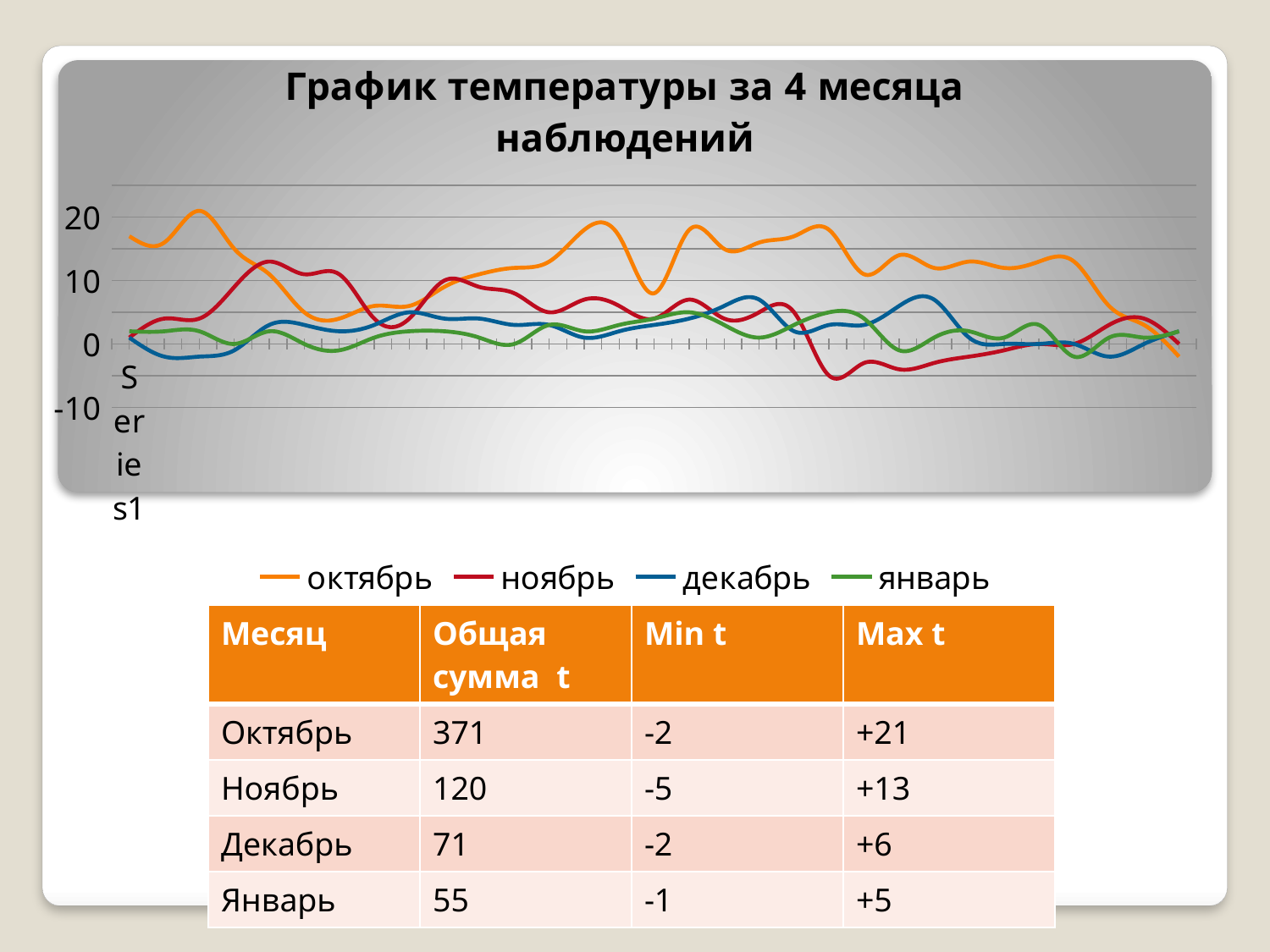
Is the first value of the октябрь line greater or less than 10? greater What kind of chart is shown on the slide? line chart Does the октябрь line overall rise or fall from left to right? fall How many series does the chart legend list? 4 Which series reaches the highest value on the chart? октябрь What is the title of the chart? График температуры за 4 месяца наблюдений Is the lowest value of the ноябрь line greater or less than 0? less Which colour is used for the ноябрь series in the chart? red Which line is higher for most of the chart, октябрь or январь? октябрь Is the highest value of the ноябрь line greater or less than 10? greater